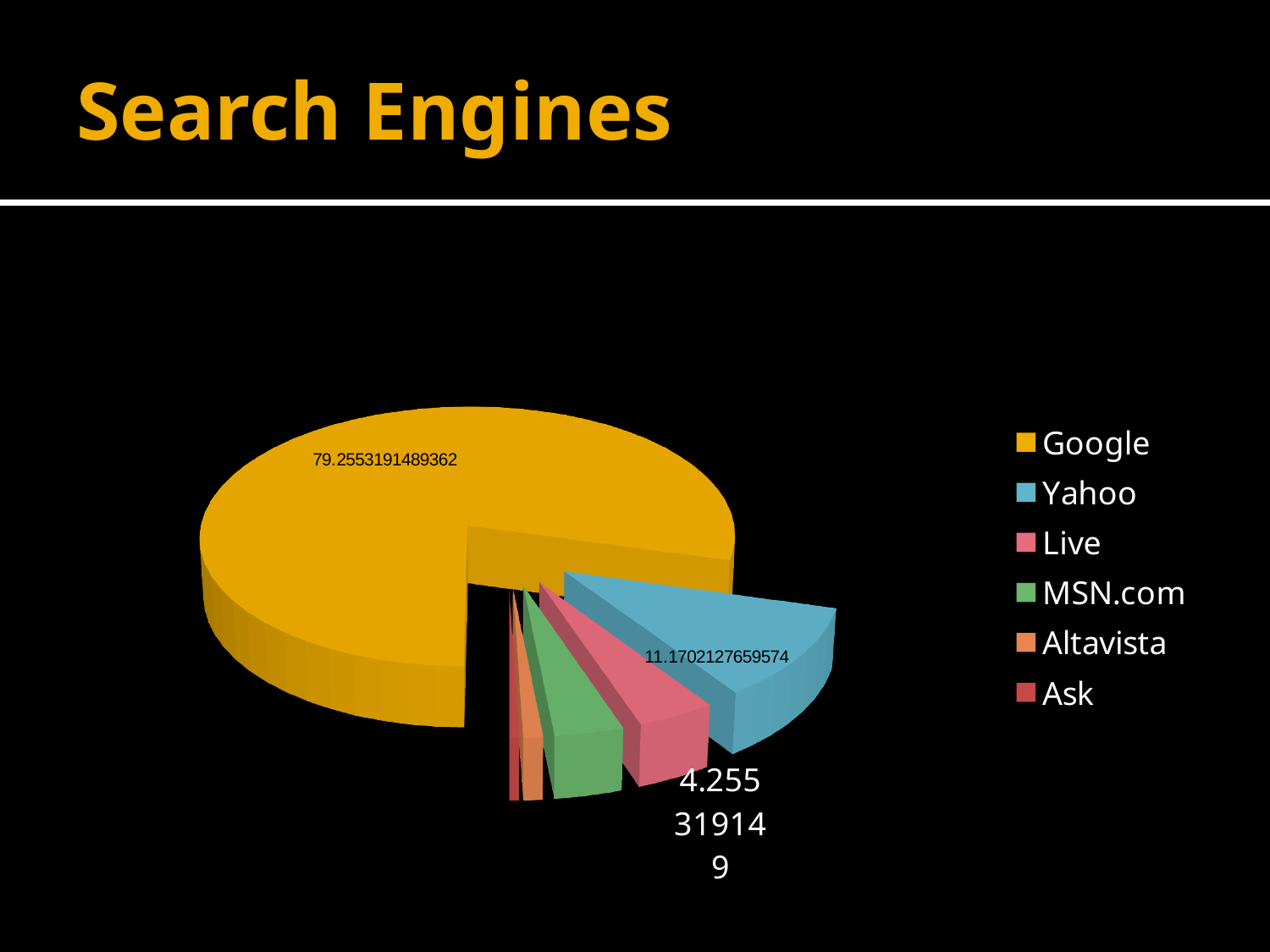
What value is labelled on the Google slice? 79.2553191489362 What is the title of the chart on the slide? Search Engines What value is labelled on the Yahoo slice? 11.1702127659574 Which is larger, the Yahoo slice or the Live slice? Yahoo How many slices does the pie chart have? 6 What colour is the Google slice in the pie chart? yellow What value is labelled on the Live slice? 4.255319149 What kind of chart is shown on the slide? pie chart Which search engine has the largest slice of the pie? Google How many entries does the legend list? 6 What is the difference between the Google value and the Yahoo value? 68.0851063829788 Which is larger, the Google slice or the Yahoo slice? Google